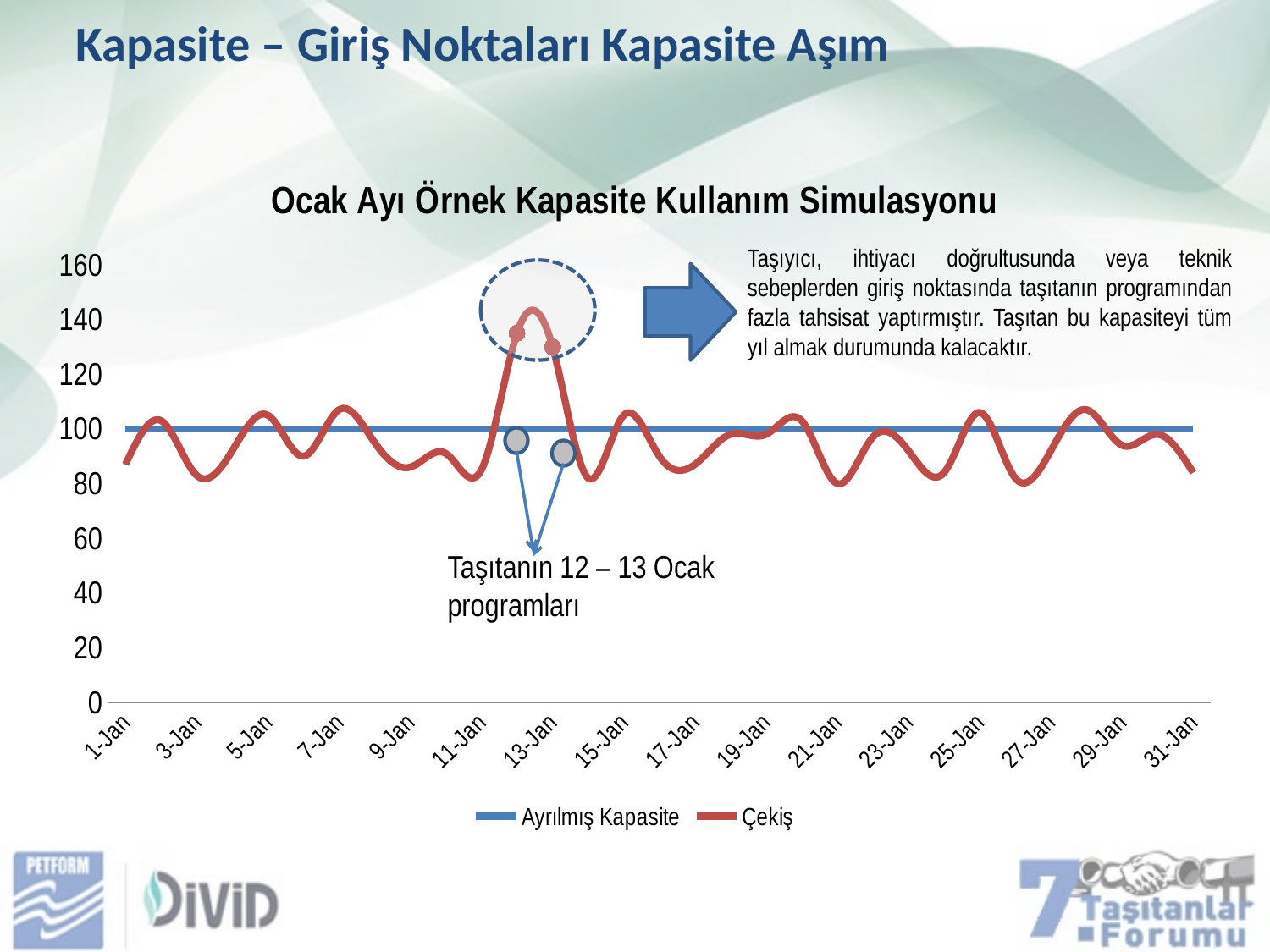
On 3-Jan, which series has the larger value, Ayrılmış Kapasite or Çekiş? Ayrılmış Kapasite How many date labels are shown on the x axis? 16 What constant value does the Ayrılmış Kapasite line hold across the month? 100 Is the Çekiş value on 13-Jan greater or less than 120? greater Does the Çekiş line rise or fall between 11-Jan and 13-Jan? rise How many series does the chart legend list? 2 Is the Çekiş value on 3-Jan greater or less than 100? less What type of chart is shown on the slide? line chart What is the title of the chart? Ocak Ayı Örnek Kapasite Kullanım Simulasyonu What are the two series named in the chart legend? Ayrılmış Kapasite and Çekiş On 13-Jan, which series has the larger value, Ayrılmış Kapasite or Çekiş? Çekiş Is the Çekiş value on 21-Jan greater or less than 100? less